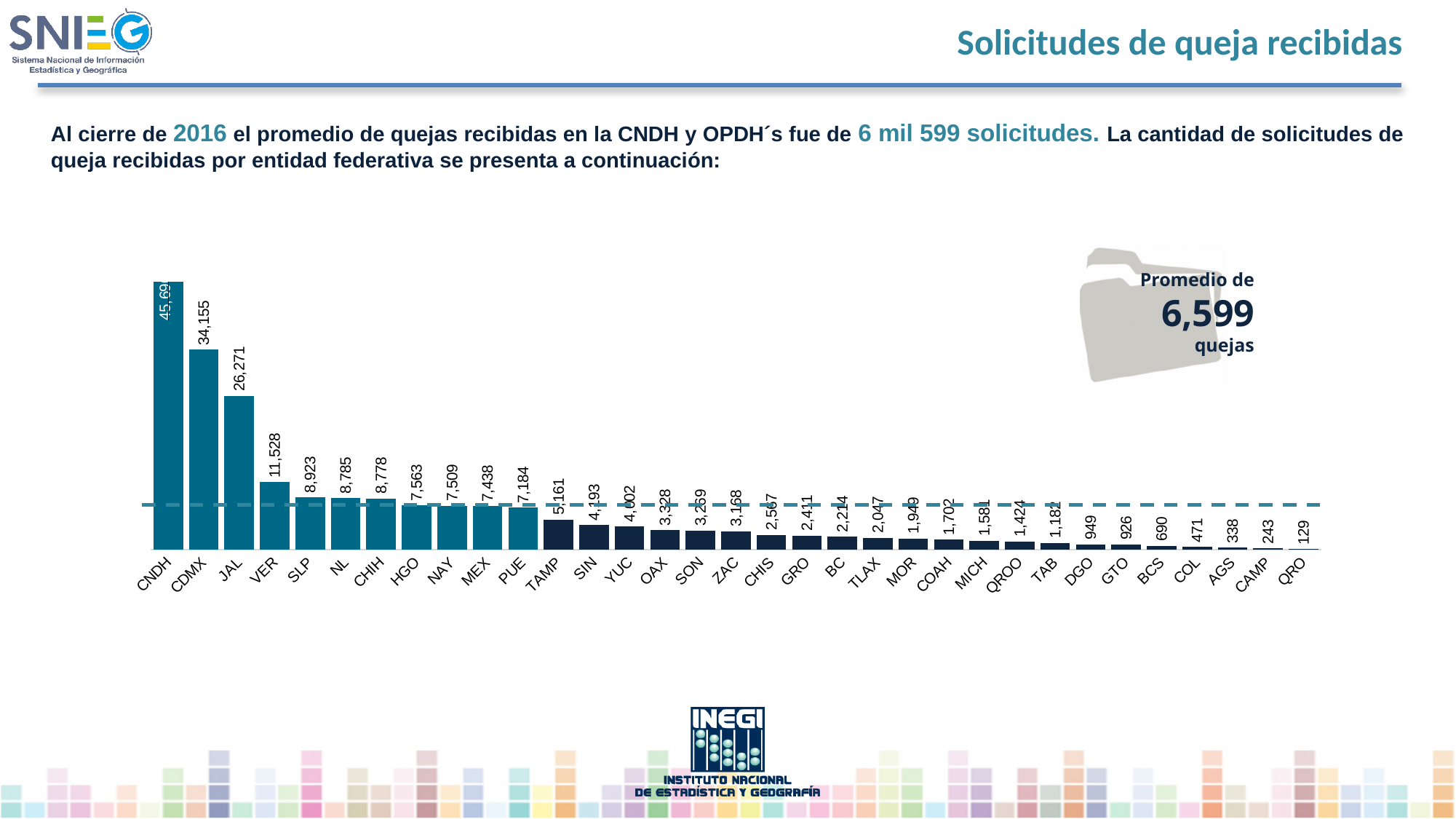
Which category has the highest value? CNDH Which is larger, the value for VER or the value for SLP? VER What is the value for JAL? 26,271 Which category has the lowest value? QRO What is the difference between the values for SLP and NL? 138 What kind of chart is shown on the slide? bar chart Do the values rise or fall from left to right along the x axis? fall What is the value for QRO? 129 What is the difference between the values for CDMX and JAL? 7,884 What is the value for CDMX? 34,155 What is the value for TAMP? 5,161 How many categories are shown on the x axis? 33